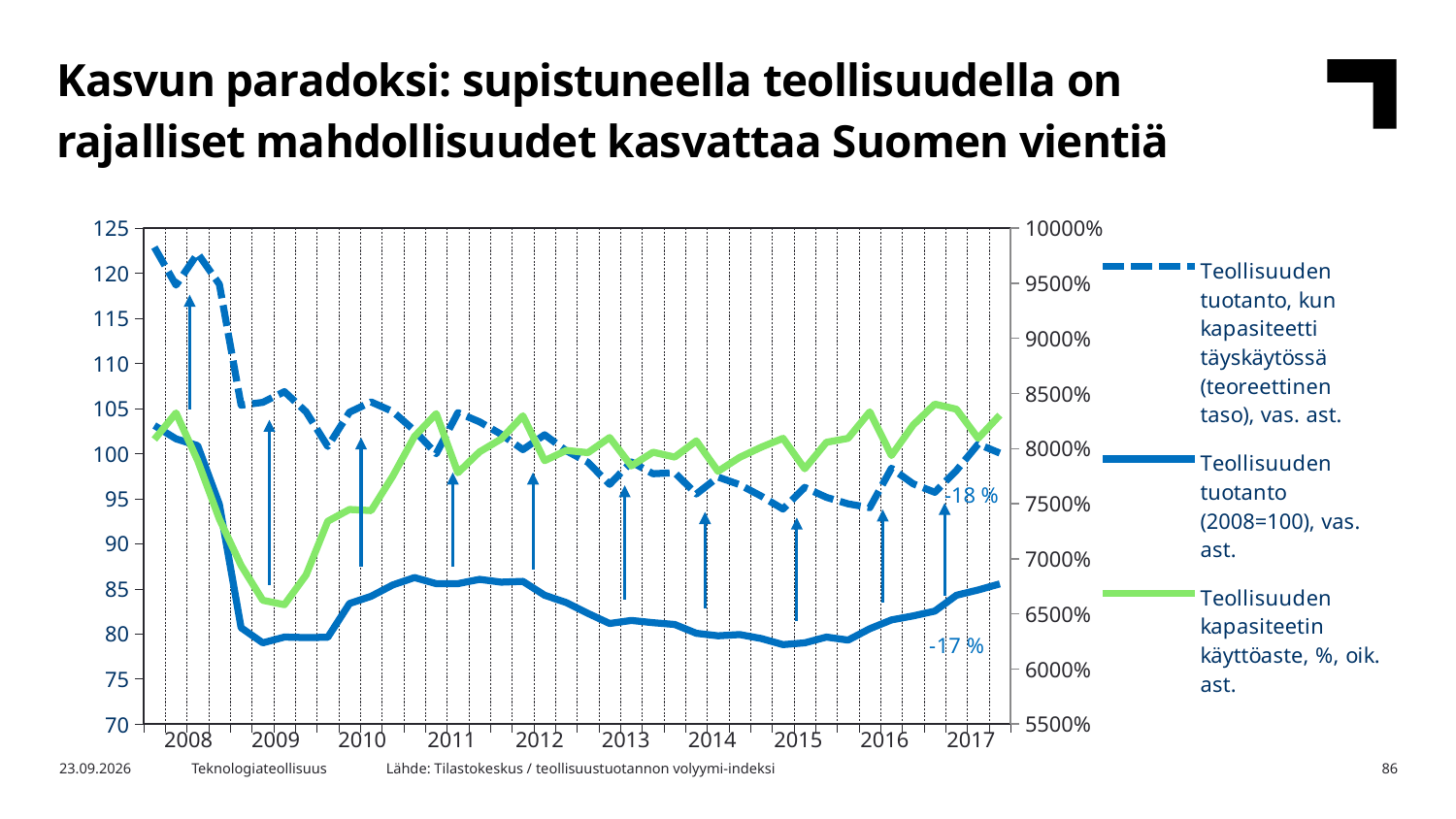
What percentage change is annotated near the solid blue line at the right end of the chart? -17 % In 2009, which is higher on the left axis: the dashed blue line or the solid blue line? the dashed blue line Is the value of the dashed blue line at the start of 2008 greater or less than 120 on the left axis? greater How many series does the legend list? 3 Is the value of the solid blue line (Teollisuuden tuotanto, 2008=100) in 2009 greater or less than 85 on the left axis? less What percentage change is annotated near the dashed line at the right end of the chart? -18 % How many year labels are shown on the x axis? 10 Does the solid blue line (Teollisuuden tuotanto, 2008=100) rise or fall from 2008 to 2009? fall What kind of chart is shown on the slide? line chart Is the value of the solid blue line (Teollisuuden tuotanto, 2008=100) at the end of 2017 greater or less than 90 on the left axis? less Which series is drawn in green? Teollisuuden kapasiteetin käyttöaste, %, oik. ast. Which year is the first label on the x axis? 2008